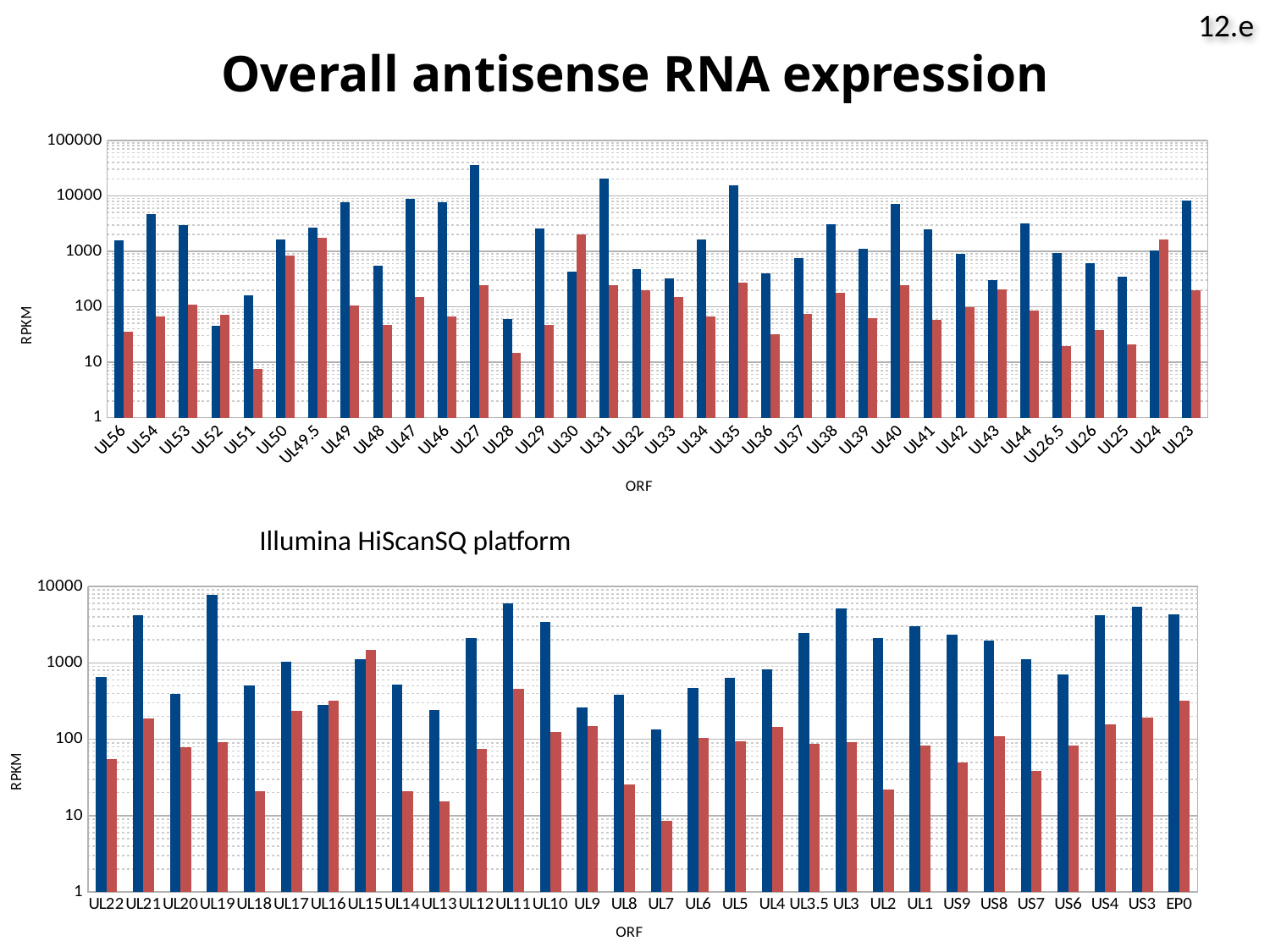
What kind of chart is the top chart on the slide? bar chart How many ORF categories are shown on the x axis of the top chart? 34 In the top chart, which is larger, the blue bar for UL27 or the blue bar for UL31? UL27 What is the label on the y axis of the bottom chart? RPKM In the bottom chart, which is larger for UL15, the blue bar or the red bar? red bar In the bottom chart, is the red bar for UL15 greater or less than 1000? greater How many ORF categories are shown on the x axis of the bottom chart? 30 In the top chart, is the red bar for UL30 greater or less than 1000? greater In the bottom chart, is the red bar for UL7 greater or less than 10? less In the top chart, which ORF has the tallest bar? UL27